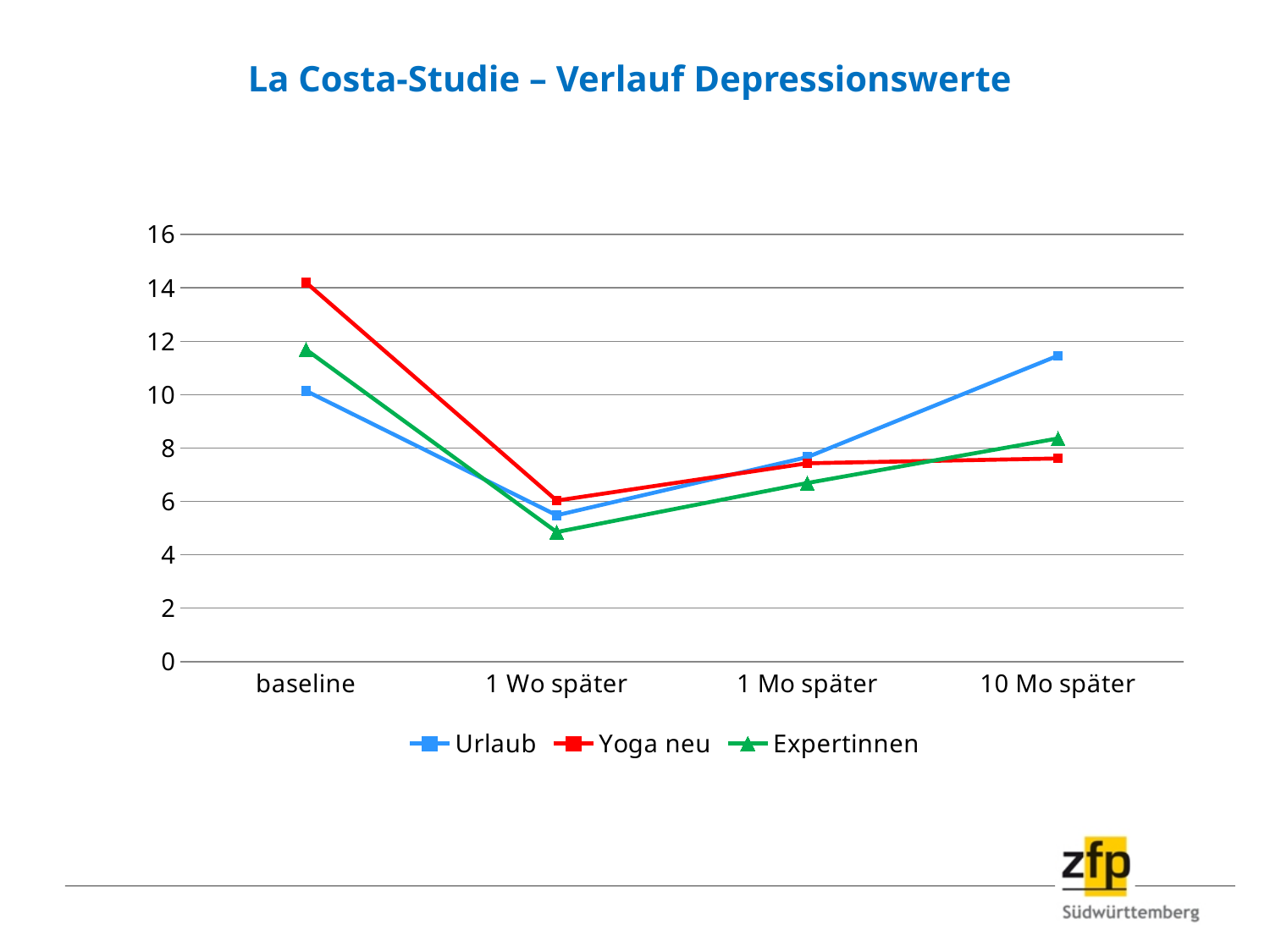
How many series does the legend list? 3 Is the value for Expertinnen at 1 Wo später greater or less than 6? less What is the title of the chart? La Costa-Studie – Verlauf Depressionswerte What kind of chart is shown on the slide? line chart Which series has the highest value at 10 Mo später? Urlaub Which series has the highest value at baseline? Yoga neu Which series has the lowest value at 1 Wo später? Expertinnen Does the Urlaub series rise or fall from 1 Wo später to 10 Mo später? rise At baseline, which is larger: the value for Expertinnen or the value for Urlaub? Expertinnen Is the value for Urlaub at 10 Mo später greater or less than 10? greater How many time points are shown on the x axis? 4